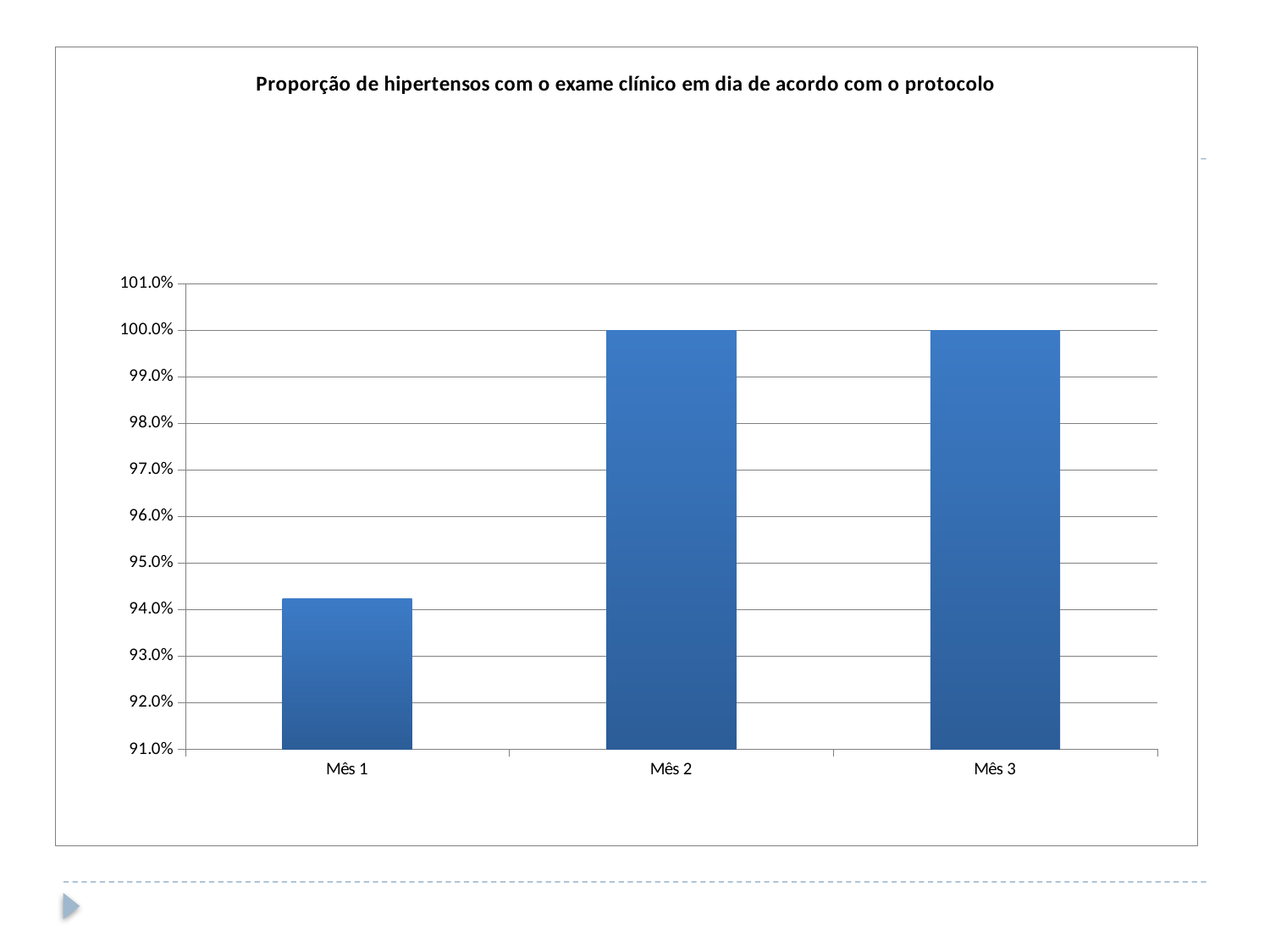
What kind of chart is shown on the slide? bar chart Which month has the lowest value? Mês 1 What is the value for Mês 3? 100.0% What is the lowest value shown on the y axis of the chart? 91.0% What is the value for Mês 2? 100.0% Which is larger, the value for Mês 1 or the value for Mês 2? Mês 2 What is the difference between the values for Mês 2 and Mês 3? 0.0% Is the value for Mês 1 greater or less than 95.0%? less What is the title of the chart? Proporção de hipertensos com o exame clínico em dia de acordo com o protocolo How many categories are shown on the x axis of the chart? 3 Is the value for Mês 1 greater or less than 93.0%? greater Does the value rise or fall from Mês 1 to Mês 2? rise